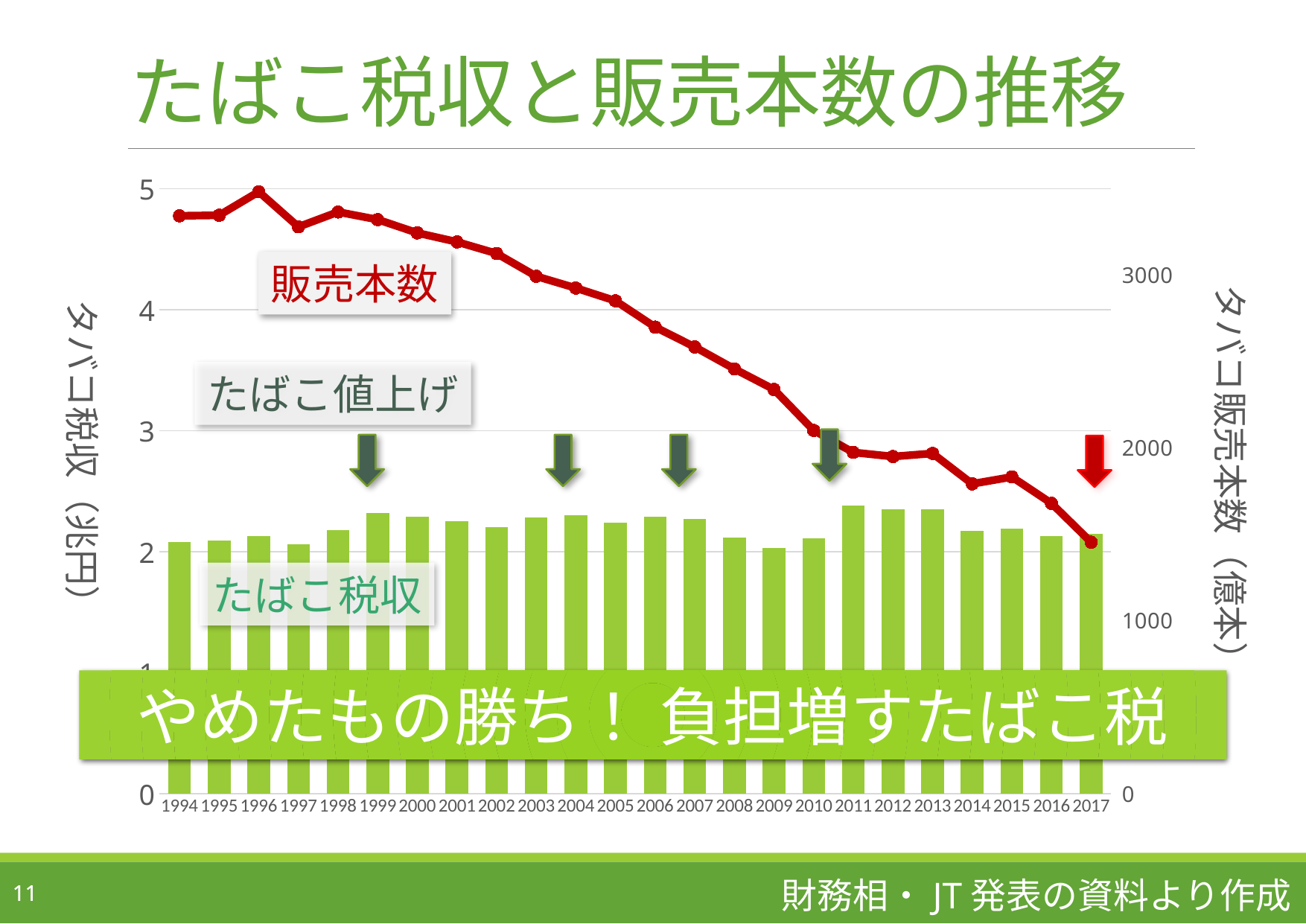
What is the title of the chart on the slide? たばこ税収と販売本数の推移 Is the 販売本数 value for 1994 greater or less than 3000? greater Which year has the larger たばこ税収 bar, 1999 or 2009? 1999 In which year does the 販売本数 line reach its lowest point? 2017 How many years are shown along the x axis of the chart? 24 How many data series are plotted in the chart? 2 Is the たばこ税収 bar for 2011 greater or less than 2? greater Is the 販売本数 value for 2017 greater or less than 2000? less What kind of chart is shown on the slide? A combined bar and line chart Which series is drawn as a red line? 販売本数 In which year does the 販売本数 line reach its highest point? 1996 Does the 販売本数 line rise or fall overall from 1994 to 2017? Falls